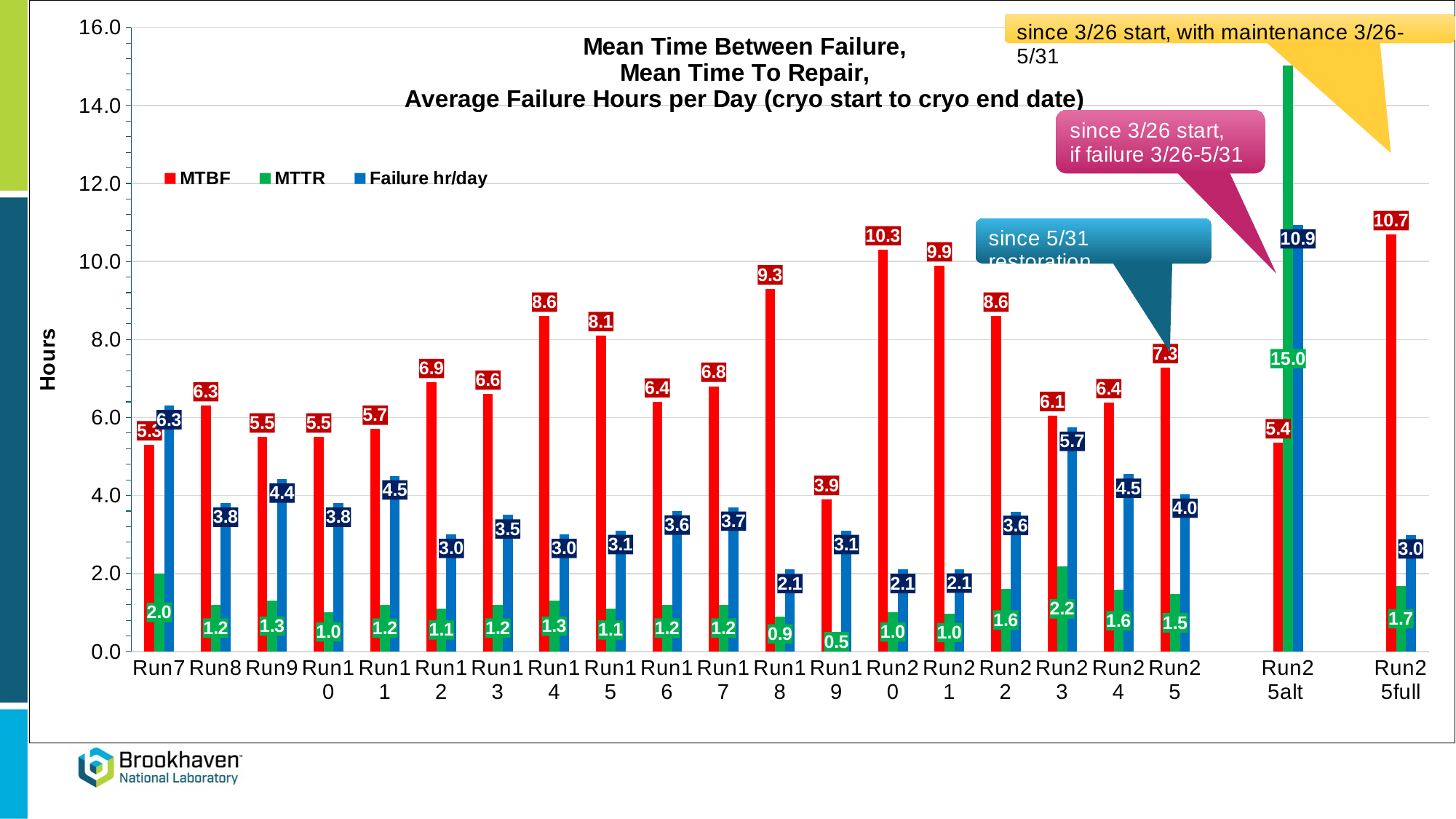
How many series does the legend list? 3 Which run has the lowest MTTR? Run19 How many runs (categories) are shown on the x axis? 21 What kind of chart is shown on the slide? Bar chart Which run has the highest MTBF? Run25full Which is larger, the Failure hr/day for Run7 or for Run8? Run7 What is the Failure hr/day value for Run23? 5.7 What is the MTTR value for Run25alt? 15.0 Which run has the lowest MTBF? Run19 What is the label of the y axis? Hours What is the MTBF value for Run20? 10.3 What is the difference between the MTBF of Run25full and the MTBF of Run25alt? 5.3